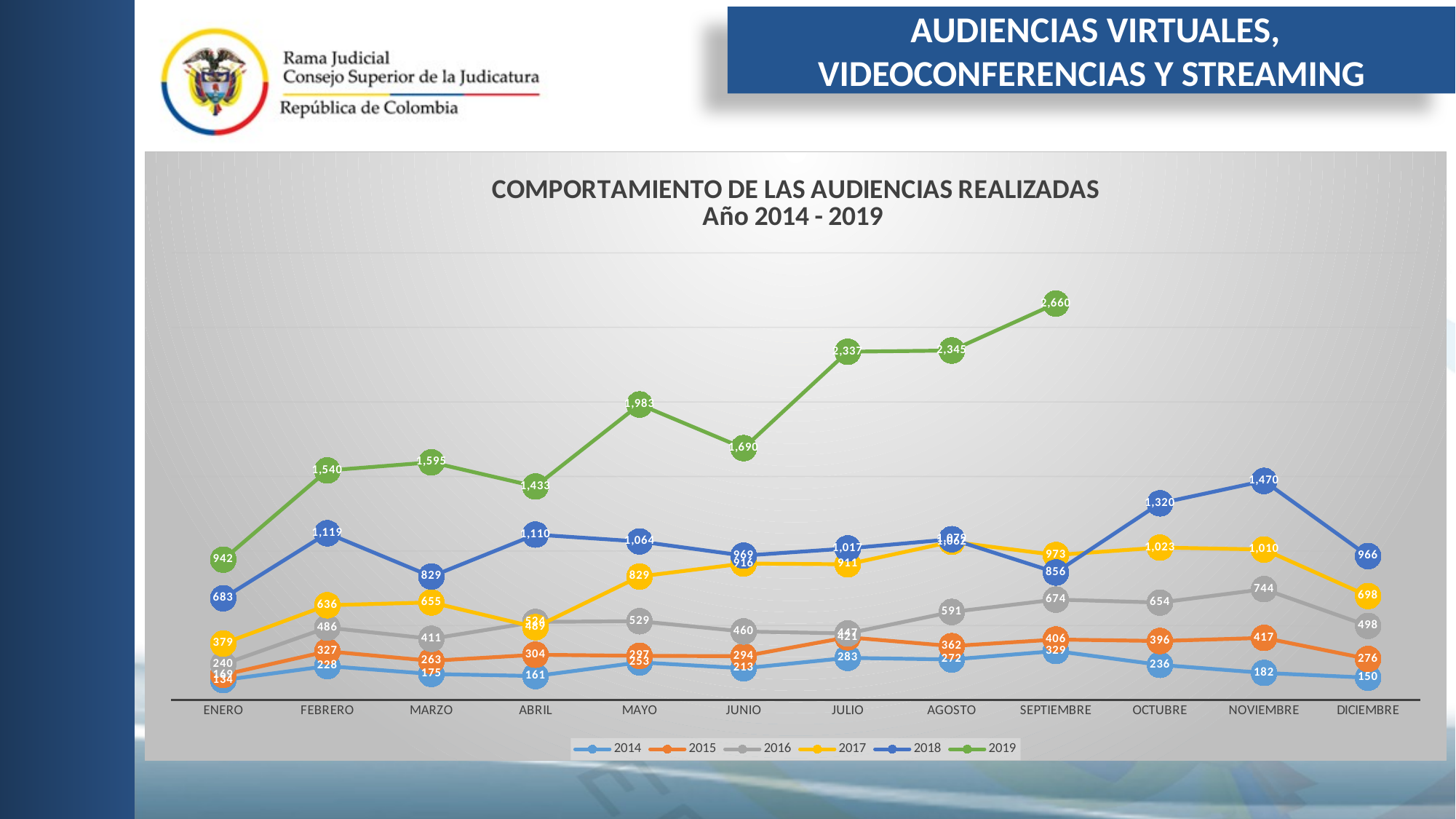
In which month does the 2019 series reach its highest value? SEPTIEMBRE What is the value for 2019 in SEPTIEMBRE? 2,660 What is the value for 2016 in NOVIEMBRE? 744 In which month does the 2016 series have its lowest value? ENERO Does the 2019 series rise or fall from JULIO to SEPTIEMBRE? rise What is the value for 2018 in NOVIEMBRE? 1,470 What kind of chart is shown on the slide? line chart In OCTUBRE, which series has the larger value, 2018 or 2017? 2018 How many months are shown along the x axis? 12 What is the difference between the 2019 values for MARZO and FEBRERO? 55 What is the difference between the 2018 values for NOVIEMBRE and DICIEMBRE? 504 How many series does the legend list? 6